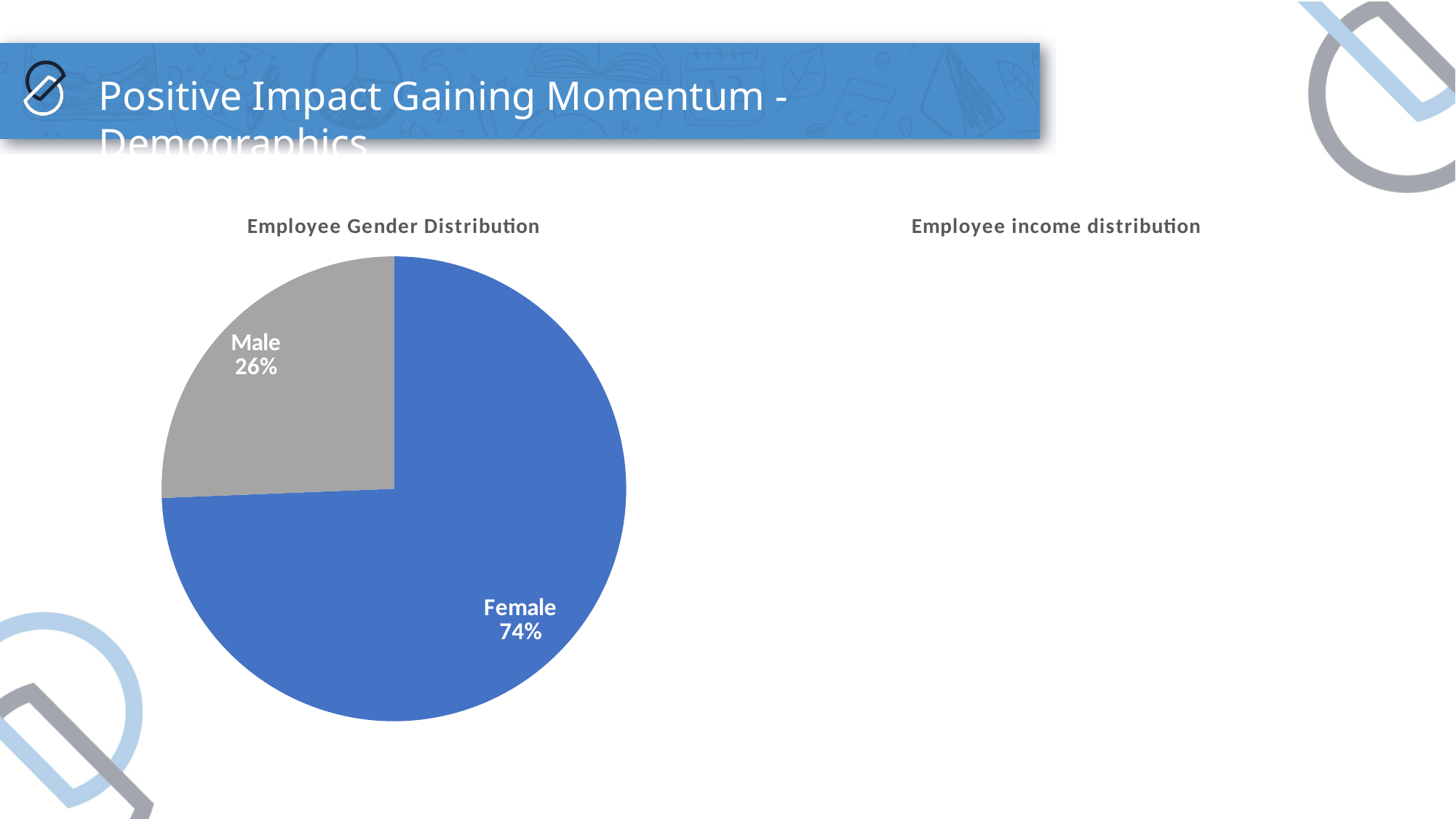
In the Employee Gender Distribution chart, what colour is the Female slice? Blue In the Employee Gender Distribution chart, what percentage of employees are female? 74% How many slices does the Employee Gender Distribution pie chart have? 2 In the Employee Gender Distribution chart, which category has the smallest share? Male In the Employee Gender Distribution chart, what colour is the Male slice? Grey In the Employee Gender Distribution chart, which category has the largest share? Female In the Employee Gender Distribution chart, what percentage of employees are male? 26% In the Employee Gender Distribution chart, which is larger, the Male share or the Female share? Female What type of chart is the Employee Gender Distribution chart? Pie chart In the Employee Gender Distribution chart, what is the difference in percentage points between the Female and Male shares? 48 In the Employee Gender Distribution chart, what share of the pie does the Male slice represent? 26%